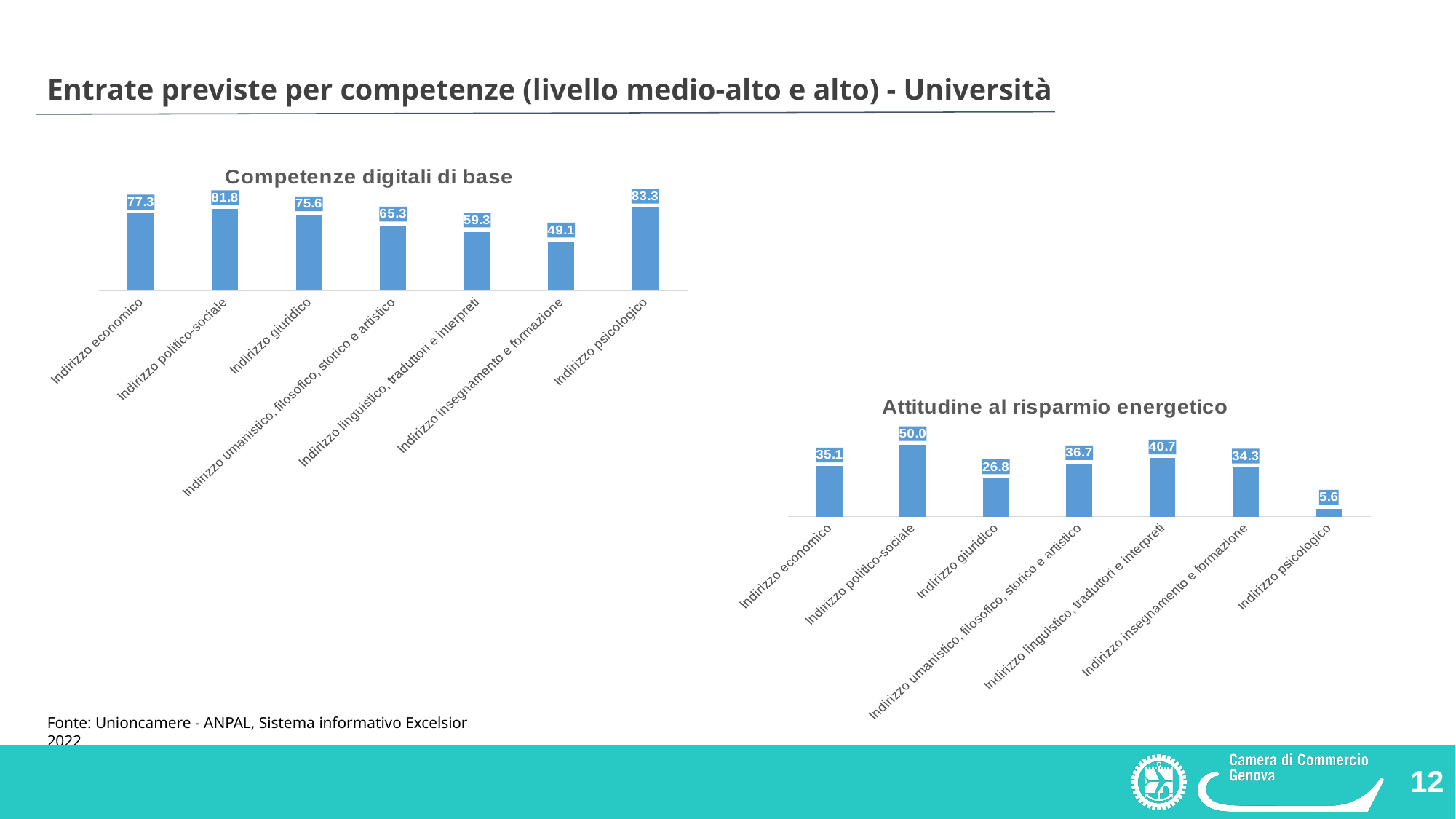
In the 'Competenze digitali di base' chart, which category has the highest value? Indirizzo psicologico In the 'Attitudine al risparmio energetico' chart, which is larger: Indirizzo economico or Indirizzo insegnamento e formazione? Indirizzo economico In the 'Competenze digitali di base' chart, which category has the lowest value? Indirizzo insegnamento e formazione In the 'Attitudine al risparmio energetico' chart, which category has the lowest value? Indirizzo psicologico What is the title of the chart on the left of the slide? Competenze digitali di base In the 'Attitudine al risparmio energetico' chart, what is the value for Indirizzo linguistico, traduttori e interpreti? 40.7 In the 'Competenze digitali di base' chart, what is the difference between Indirizzo politico-sociale and Indirizzo giuridico? 6.2 In the 'Attitudine al risparmio energetico' chart, which category has the highest value? Indirizzo politico-sociale In the 'Competenze digitali di base' chart, how many categories are shown? 7 In the 'Competenze digitali di base' chart, what is the value for Indirizzo economico? 77.3 In the 'Attitudine al risparmio energetico' chart, what is the difference between Indirizzo politico-sociale and Indirizzo giuridico? 23.2 What type of chart is the 'Attitudine al risparmio energetico' chart? Bar chart